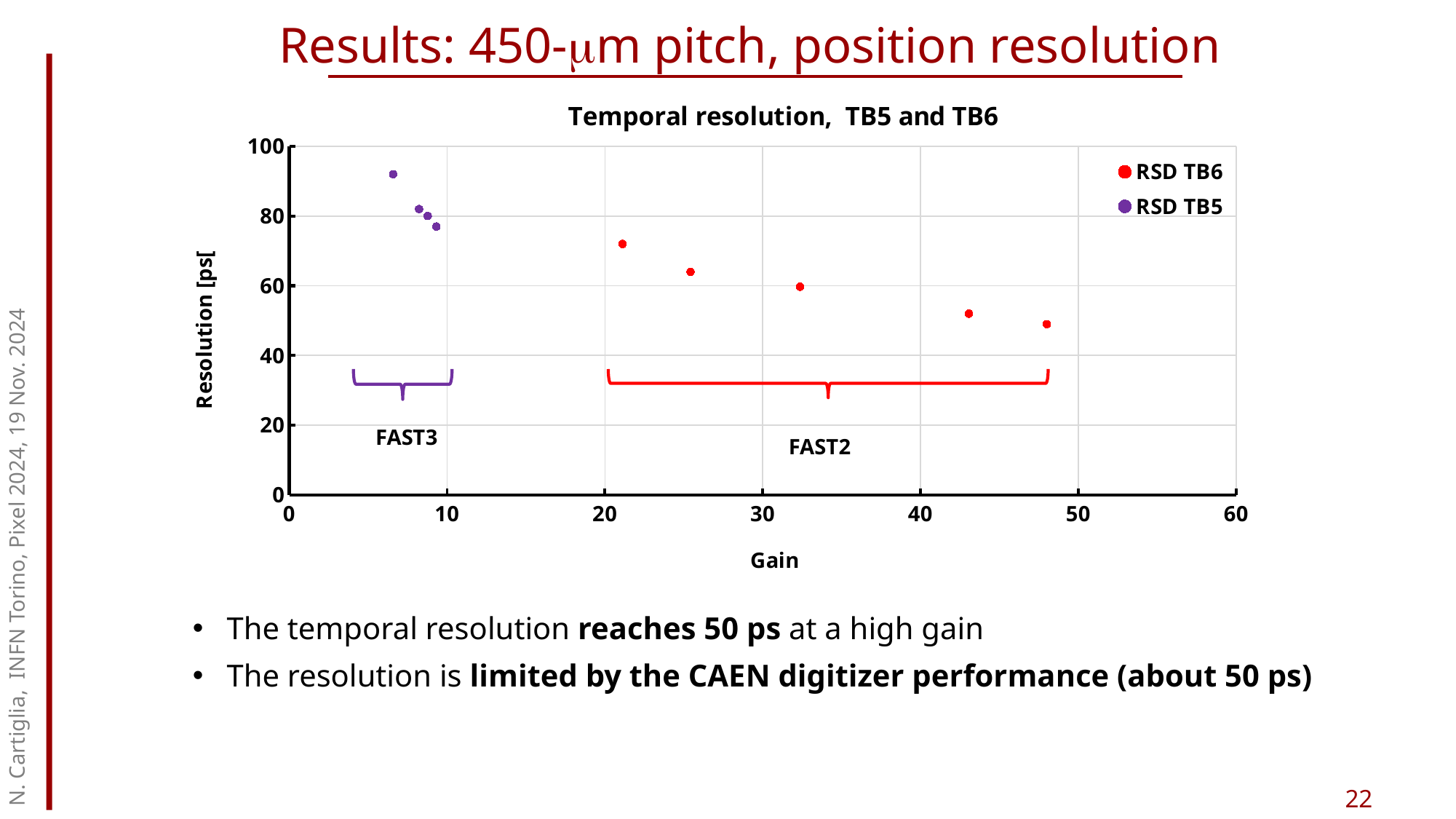
Do the RSD TB6 resolution values rise or fall as gain increases? fall Which series has the higher resolution values overall, RSD TB5 or RSD TB6? RSD TB5 Is the resolution of the highest RSD TB5 point greater or less than 80 ps? greater How many series does the legend list? 2 How many RSD TB6 data points are plotted? 5 Is the resolution of the RSD TB6 point at the highest gain greater or less than 60 ps? less What is the title of the chart? Temporal resolution, TB5 and TB6 Do the RSD TB5 resolution values rise or fall as gain increases? fall Are all RSD TB6 points plotted at gains greater or less than 20? greater What is the label of the x axis? Gain What kind of chart is shown on the slide? scatter plot How many RSD TB5 data points are plotted? 4